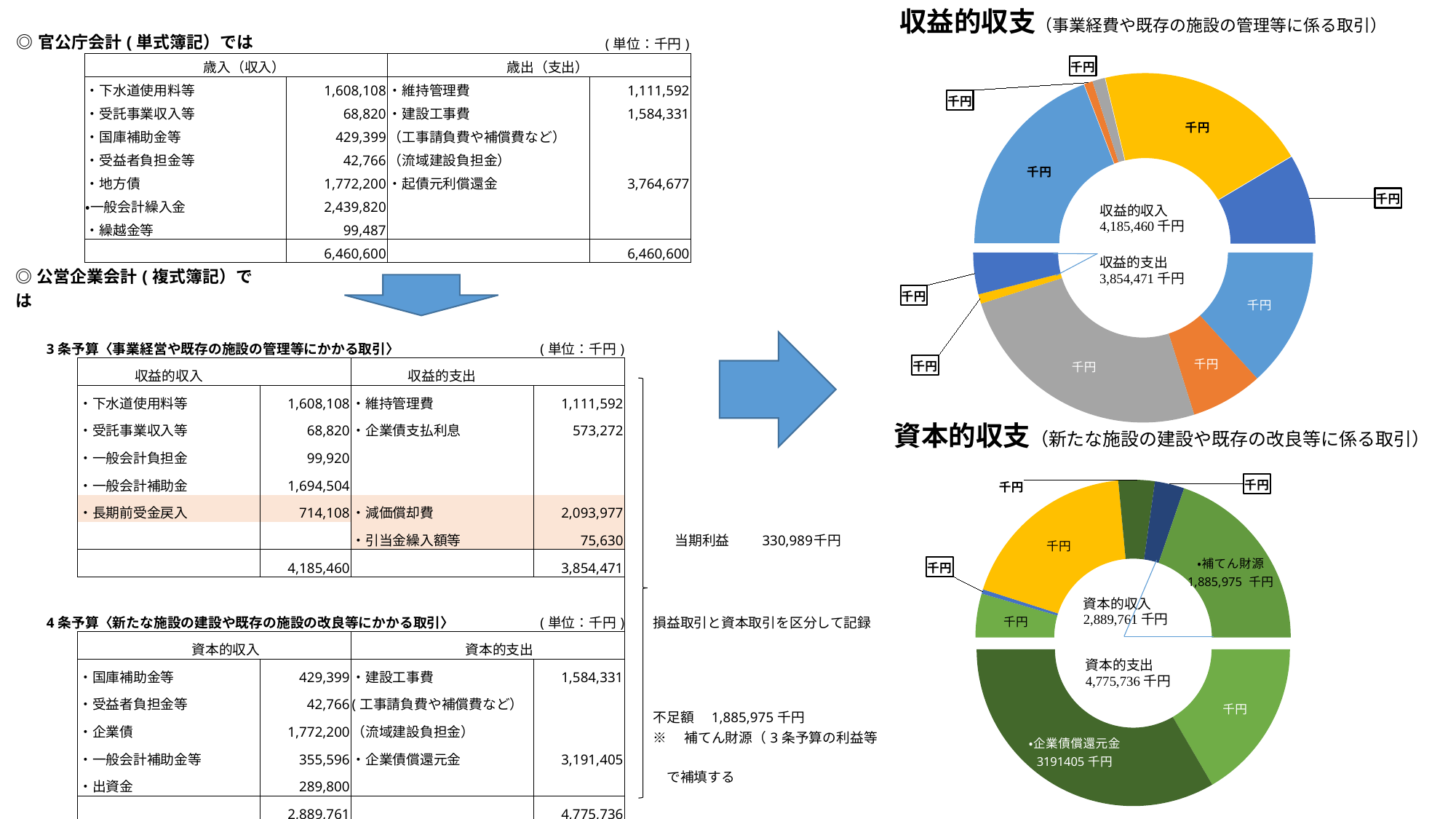
In the 資本的収支 chart, which is larger, 資本的収入 or 資本的支出? 資本的支出 In the 資本的収支 chart, what total is shown for 資本的支出? 4,775,736 千円 In the 資本的収支 chart, what total is shown for 資本的収入? 2,889,761 千円 In the 資本的収支 chart, what value is labelled for 補てん財源? 1,885,975 千円 What kind of chart is the 収益的収支 chart? doughnut chart In the 資本的収支 chart, what is the difference between 資本的支出 and 資本的収入? 1,885,975 千円 In the 収益的収支 chart, which is larger, 収益的収入 or 収益的支出? 収益的収入 In the 収益的収支 chart, what total is shown for 収益的支出? 3,854,471 千円 What kind of chart is the 資本的収支 chart? doughnut chart In the 収益的収支 chart, what total is shown for 収益的収入? 4,185,460 千円 In the 資本的収支 chart, what value is labelled for 企業債償還元金? 3191405 千円 In the 収益的収支 chart, what is the difference between 収益的収入 and 収益的支出? 330,989 千円